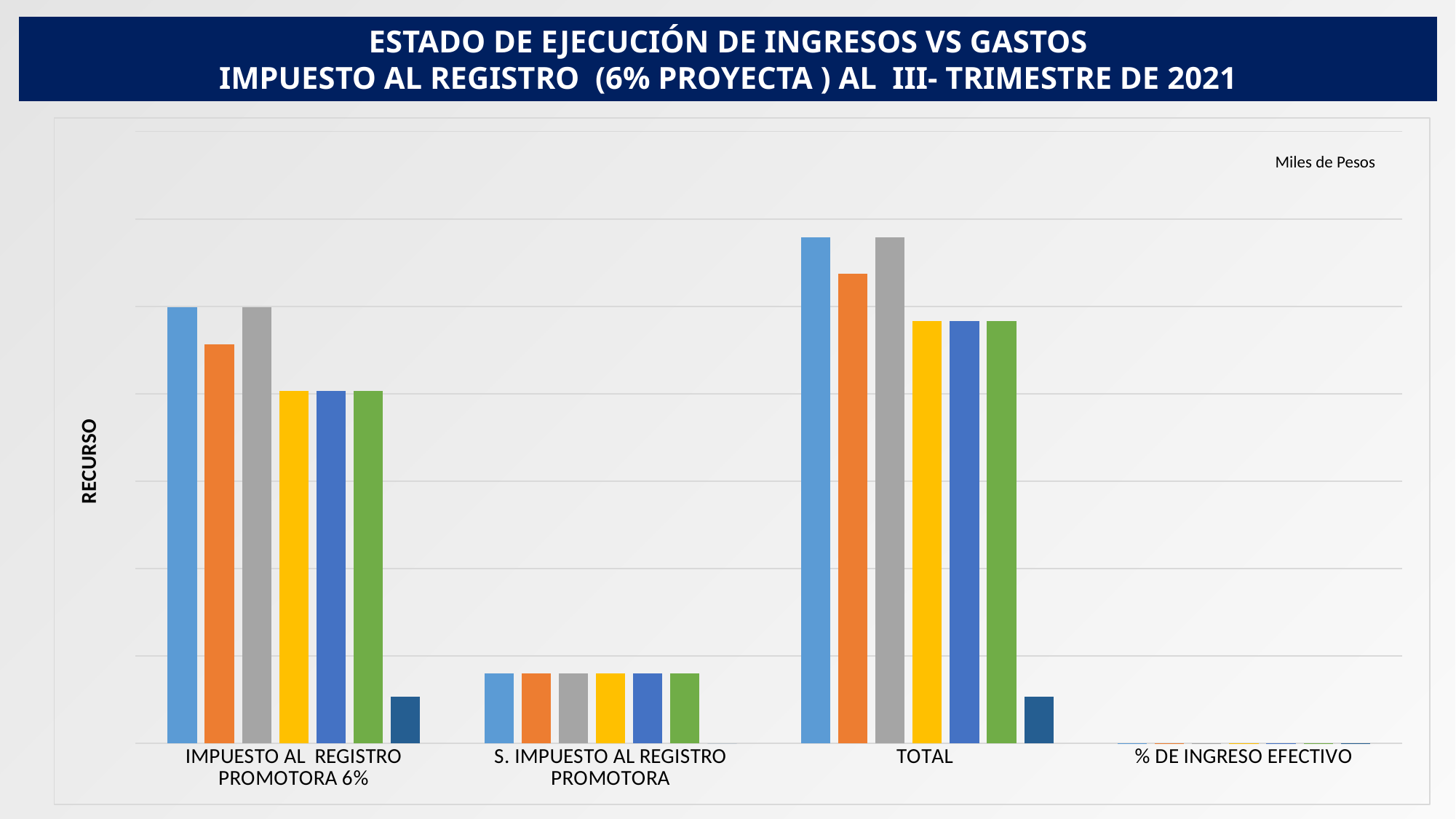
Which category has the taller light blue bar: IMPUESTO AL REGISTRO PROMOTORA 6% or S. IMPUESTO AL REGISTRO PROMOTORA? IMPUESTO AL REGISTRO PROMOTORA 6% Which category has the taller orange bar: TOTAL or IMPUESTO AL REGISTRO PROMOTORA 6%? TOTAL In the TOTAL category, which is taller: the light blue bar or the orange bar? the light blue bar How many categories are shown along the x axis of the chart? 4 Which category has the tallest bars in the chart? TOTAL What kind of chart is shown on the slide? bar chart Which category has the shortest bars in the chart? % DE INGRESO EFECTIVO What label is shown on the vertical axis of the chart? RECURSO What is the title of the chart on the slide? ESTADO DE EJECUCIÓN DE INGRESOS VS GASTOS IMPUESTO AL REGISTRO (6% PROYECTA ) AL III- TRIMESTRE DE 2021